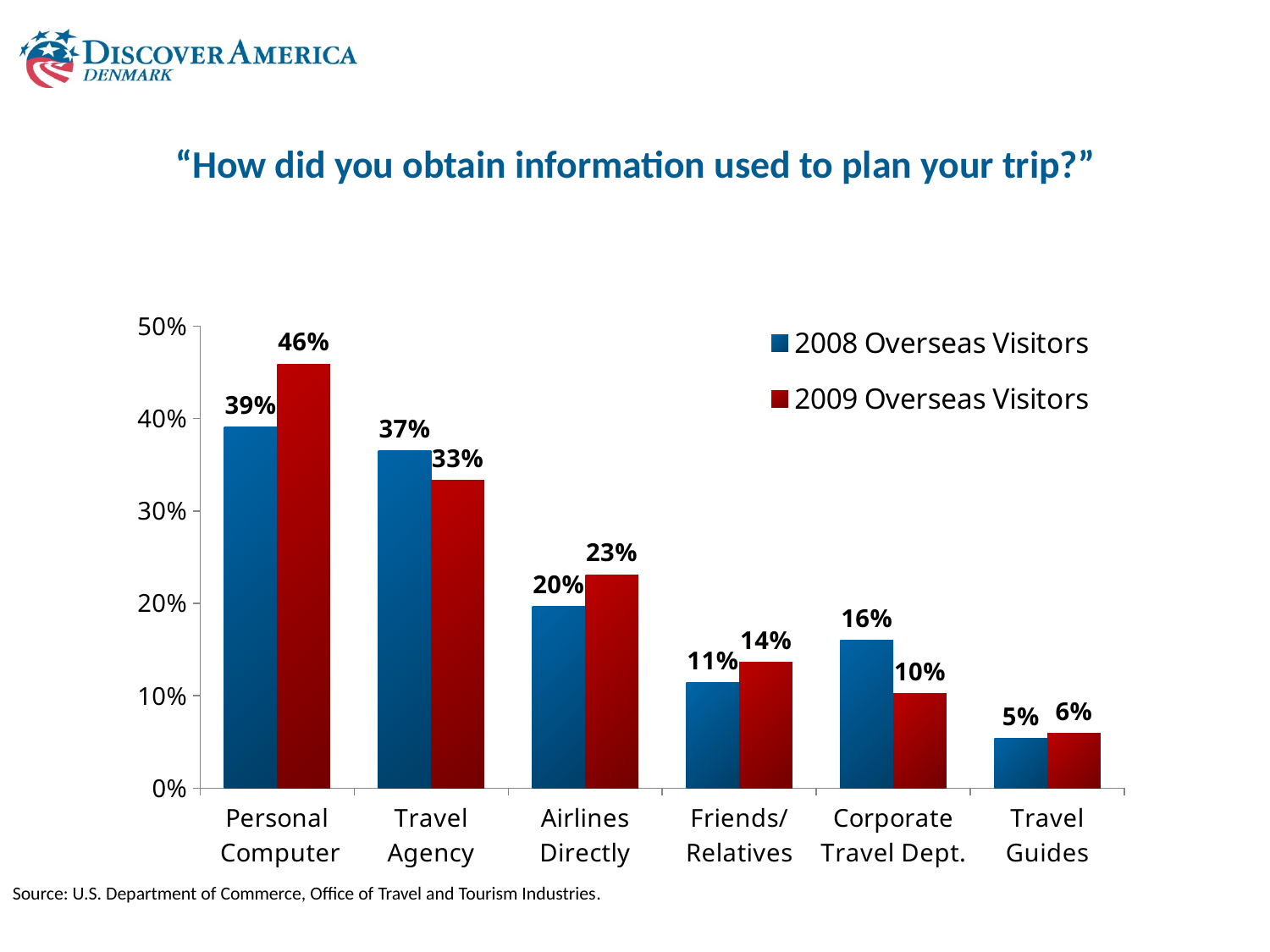
What kind of chart is shown on the slide? Bar chart Which category has the lowest value for 2008 Overseas Visitors? Travel Guides How many categories are shown on the x axis? 6 Is the 2009 Overseas Visitors value for Airlines Directly greater or less than 20%? greater What percentage of 2009 Overseas Visitors obtained information from a Personal Computer? 46% What is the title of the chart? "How did you obtain information used to plan your trip?" How many series does the legend list? 2 What is the value for 2009 Overseas Visitors for Corporate Travel Dept.? 10% Which category has the highest value for 2009 Overseas Visitors? Personal Computer What is the difference between the 2009 and 2008 values for Personal Computer? 7% What is the value for 2008 Overseas Visitors for Travel Agency? 37% Which is larger for Corporate Travel Dept.: the 2008 Overseas Visitors value or the 2009 Overseas Visitors value? 2008 Overseas Visitors